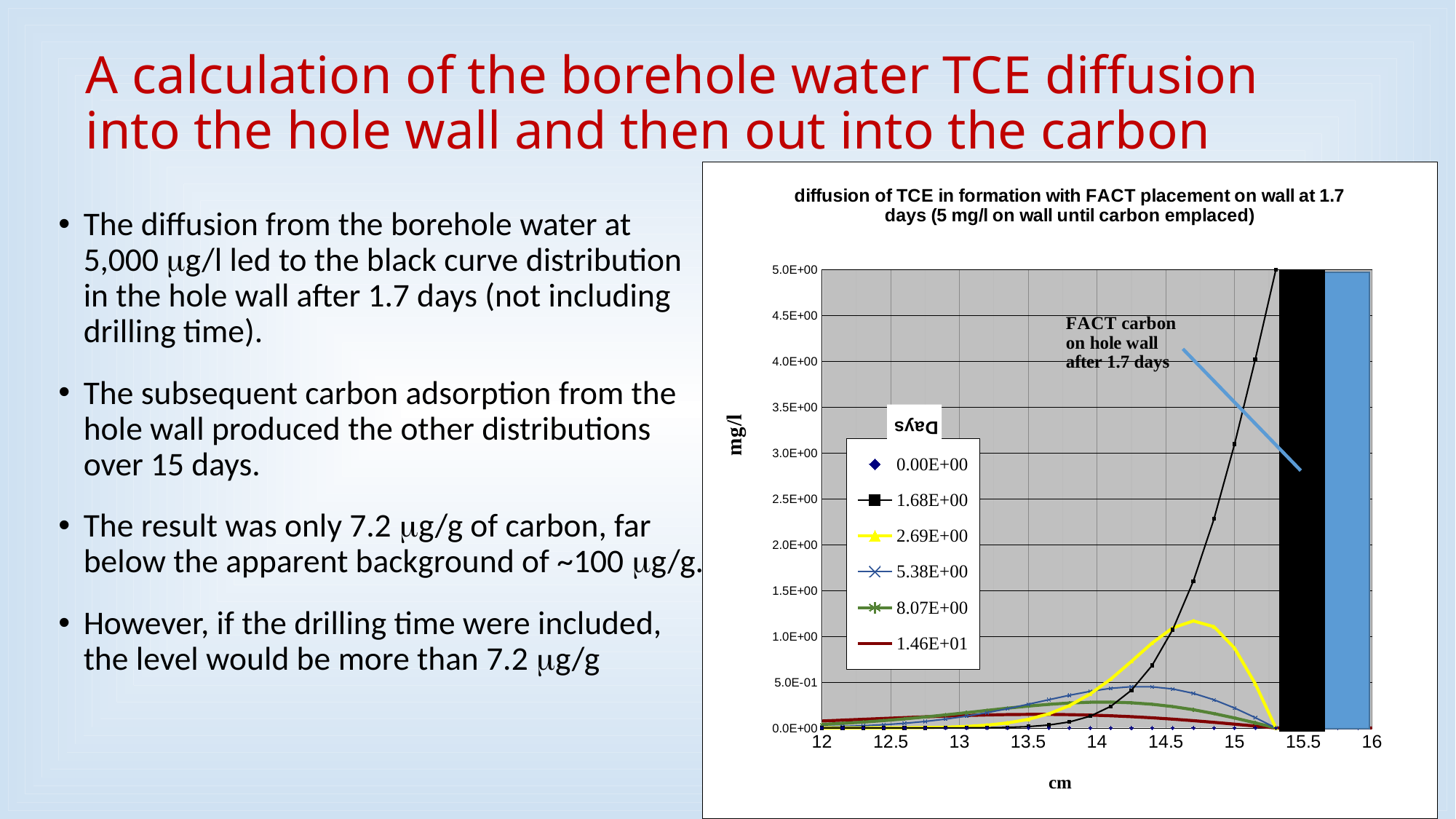
Is the peak value of the 2.69E+00 series greater or less than 1.5E+00? less How many series does the chart's legend list? 6 Which series reaches the highest value on the chart? 1.68E+00 What is the title of the chart's legend? Days Is the value of the 1.68E+00 series at 15 cm greater or less than 2.5E+00? greater What kind of chart is shown on the slide? line chart What is the label of the chart's x axis? cm Is the value of the 1.46E+01 series at 14 cm greater or less than 5.0E-01? less At 15 cm, which series has the larger value: 1.68E+00 or 2.69E+00? 1.68E+00 Does the 1.68E+00 series rise or fall as cm increases from 12 to 15? rise Which series stays lowest across the whole x axis? 0.00E+00